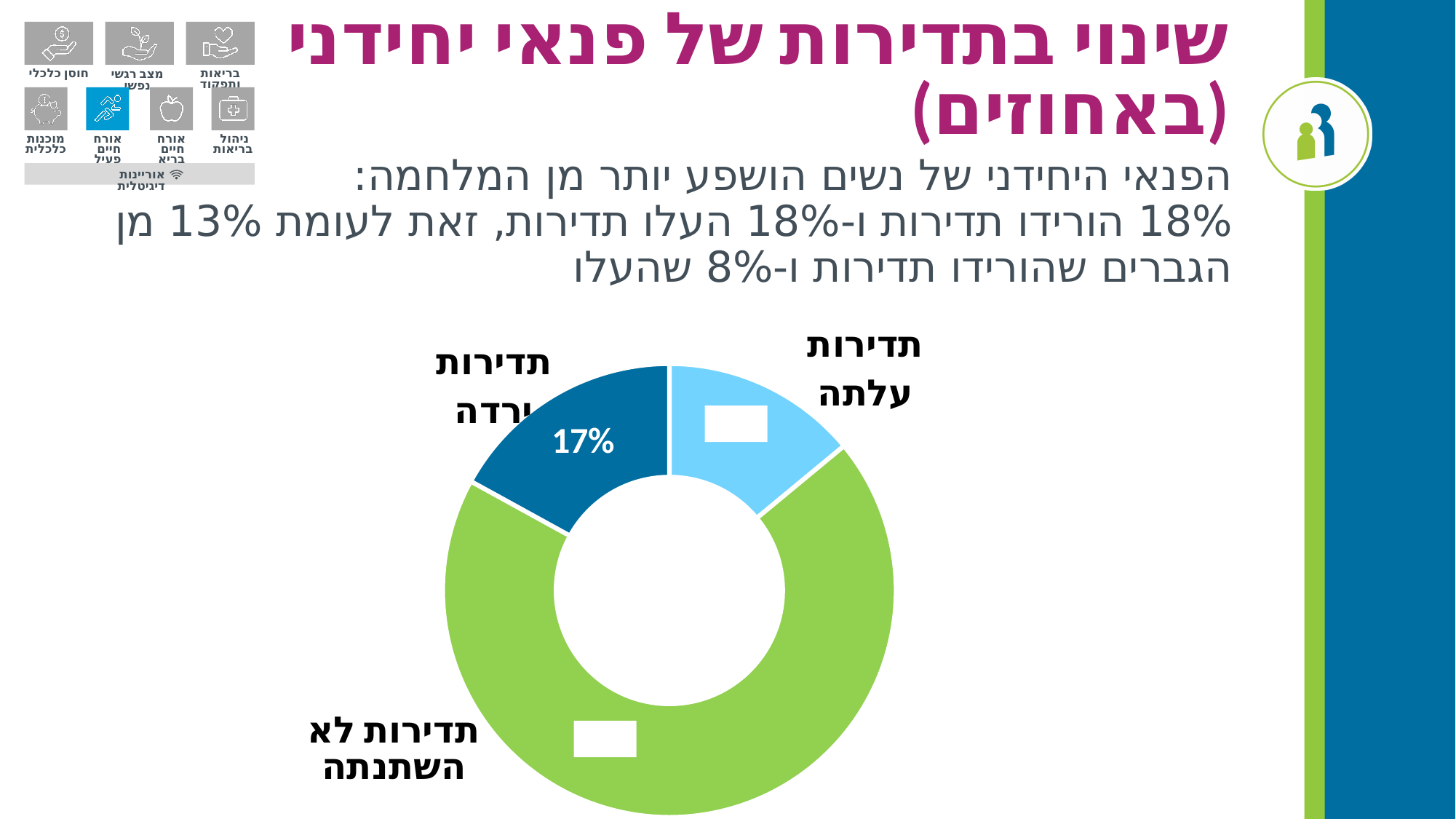
What share of the pie does the תדירות ירדה slice represent? 17% What colour is the slice labelled תדירות לא השתנתה? green What kind of chart is shown on the slide? pie chart (donut) Which slice is larger: תדירות לא השתנתה or תדירות עלתה? תדירות לא השתנתה What percentage is shown for the slice labelled תדירות ירדה? 17% How many slices does the chart have? 3 Which slice is larger: תדירות לא השתנתה or תדירות ירדה? תדירות לא השתנתה Which category has the largest slice in the chart? תדירות לא השתנתה What colour is the slice labelled תדירות עלתה? light blue